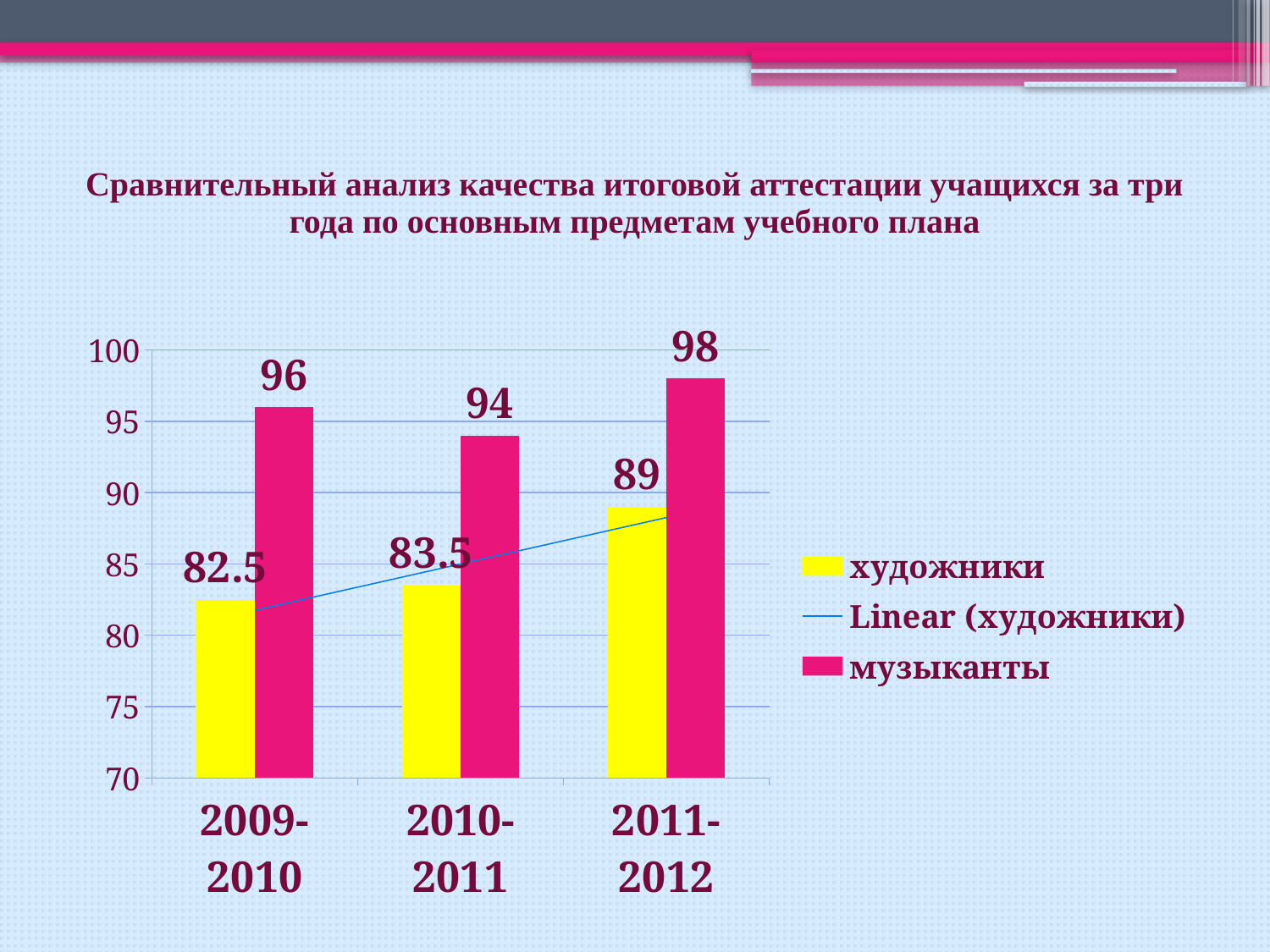
What is the value for художники in 2011-2012? 89 Which is larger in 2010-2011, художники or музыканты? музыканты What kind of chart is shown on the slide? bar chart Do the values for художники rise or fall from 2009-2010 to 2011-2012? rise What is the value for музыканты in 2011-2012? 98 What is the difference between музыканты and художники in 2009-2010? 13.5 In which year is the value for музыканты lowest? 2010-2011 How many entries does the legend list? 3 In which year is the value for художники highest? 2011-2012 What is the value for художники in 2009-2010? 82.5 What is the value for музыканты in 2010-2011? 94 How many year categories are shown on the x axis? 3